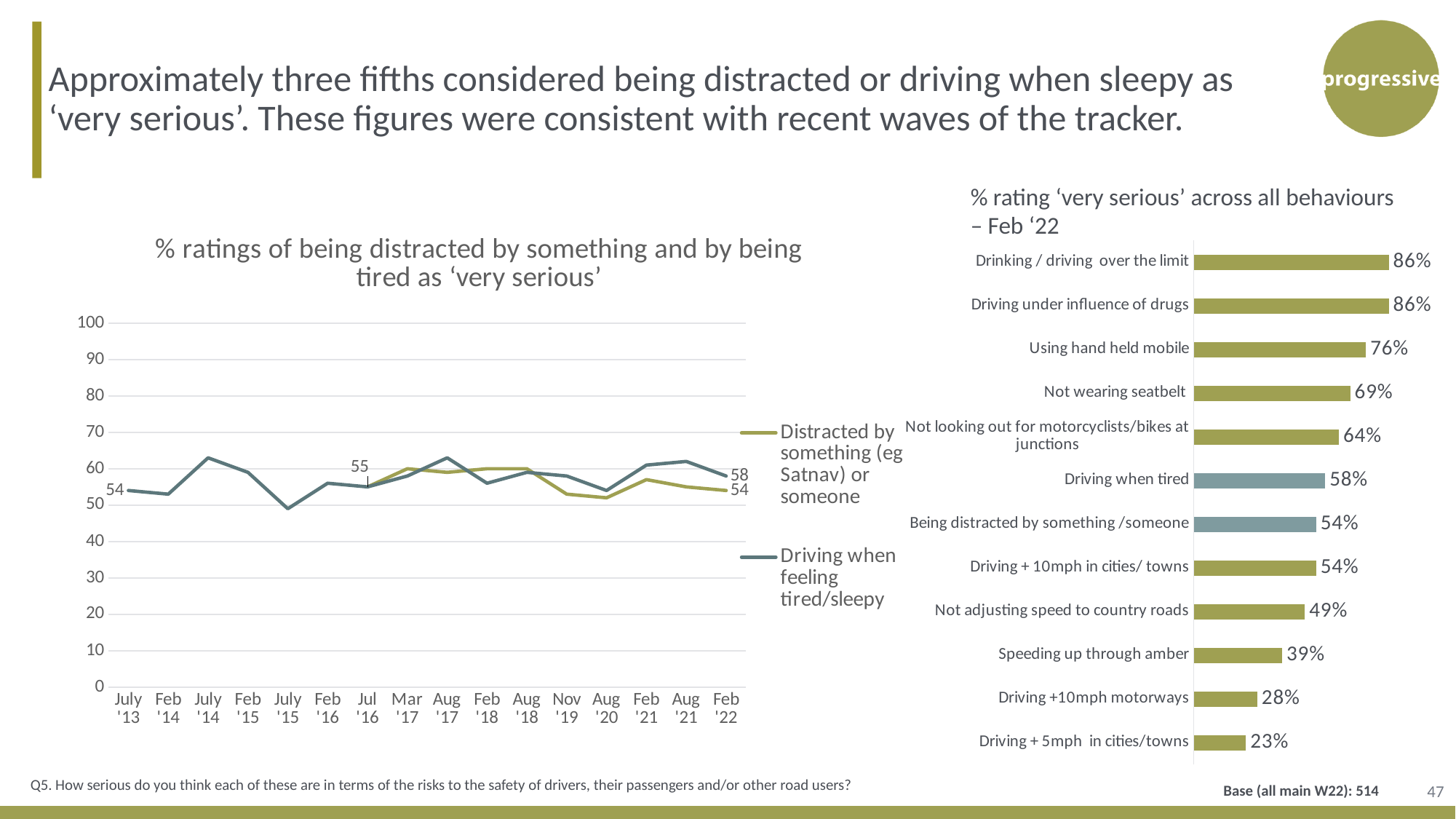
What type of chart is the chart on the left of the slide? Line chart In the line chart on the left, what is the value for 'Distracted by something (eg Satnav) or someone' at Jul '16? 55 In the bar chart on the right, what is the difference between 'Not wearing seatbelt' and 'Driving when tired'? 11% In the bar chart on the right, which is larger: 'Not adjusting speed to country roads' or 'Driving +10mph motorways'? Not adjusting speed to country roads In the bar chart '% rating ‘very serious’ across all behaviours – Feb ‘22', what is the value for 'Using hand held mobile'? 76% In the line chart on the left, what is the value for 'Driving when feeling tired/sleepy' at Feb '22? 58 In the bar chart on the right, what value is shown for 'Driving under influence of drugs'? 86% How many behaviours are listed in the bar chart on the right? 12 In the bar chart on the right, what is the value for 'Speeding up through amber'? 39% In the bar chart on the right, which behaviour has the lowest percentage rating it 'very serious'? Driving + 5mph in cities/towns How many series does the legend of the line chart on the left list? 2